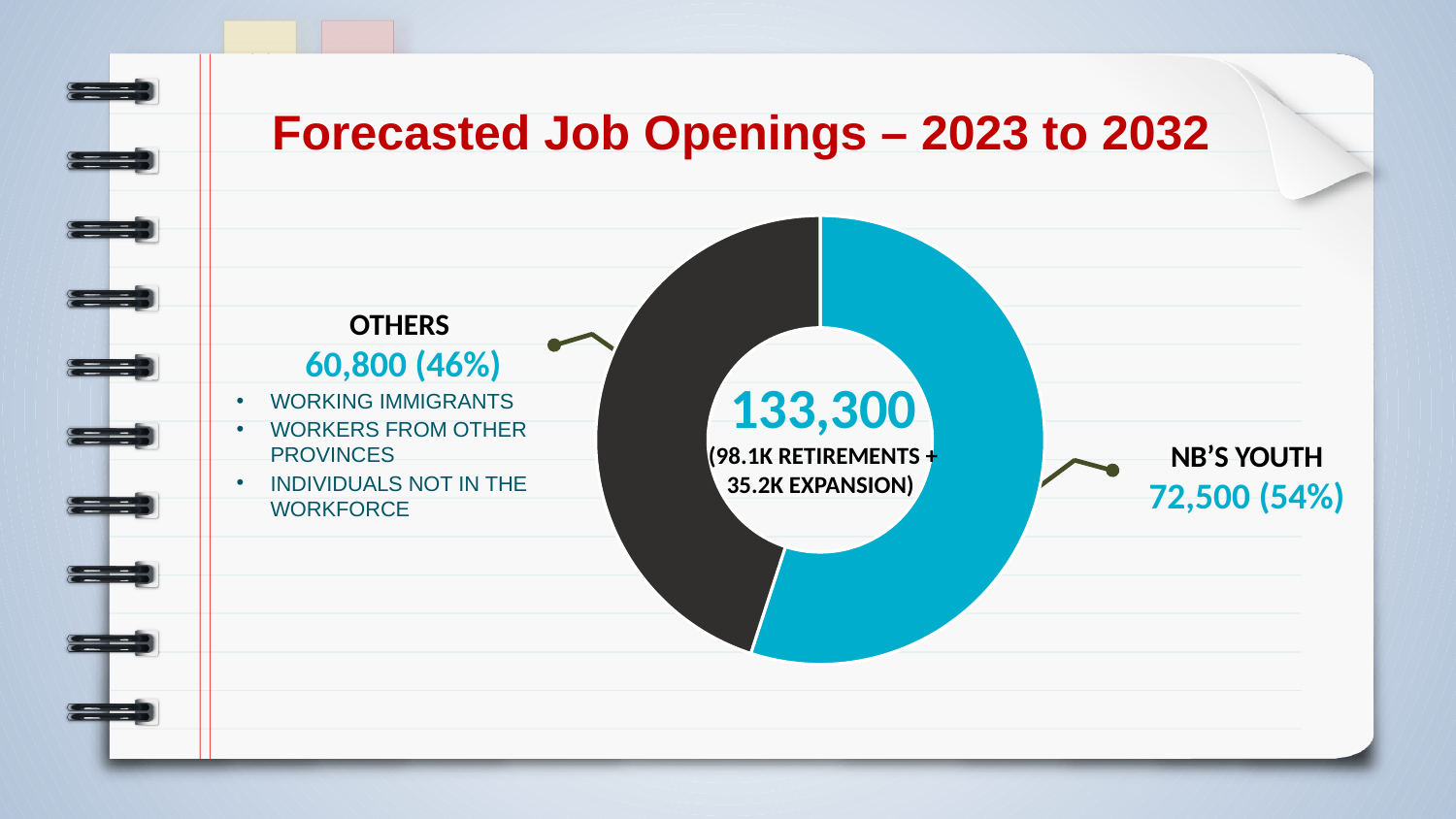
What is the total number of forecasted job openings shown in the centre of the chart? 133,300 What share of the forecasted job openings is attributed to NB's Youth? 54% What share of the forecasted job openings is attributed to Others? 46% What is the title of the chart? Forecasted Job Openings – 2023 to 2032 Which category has the smallest share of forecasted job openings? Others What is the difference in job openings between NB's Youth and Others? 11,700 How many segments does the chart have? 2 What is the forecasted number of job openings for Others? 60,800 Which segment is larger, NB's Youth or Others? NB's Youth What is the forecasted number of job openings for NB's Youth? 72,500 What kind of chart is shown on the slide? Pie chart (donut) Which category has the largest share of forecasted job openings? NB's Youth